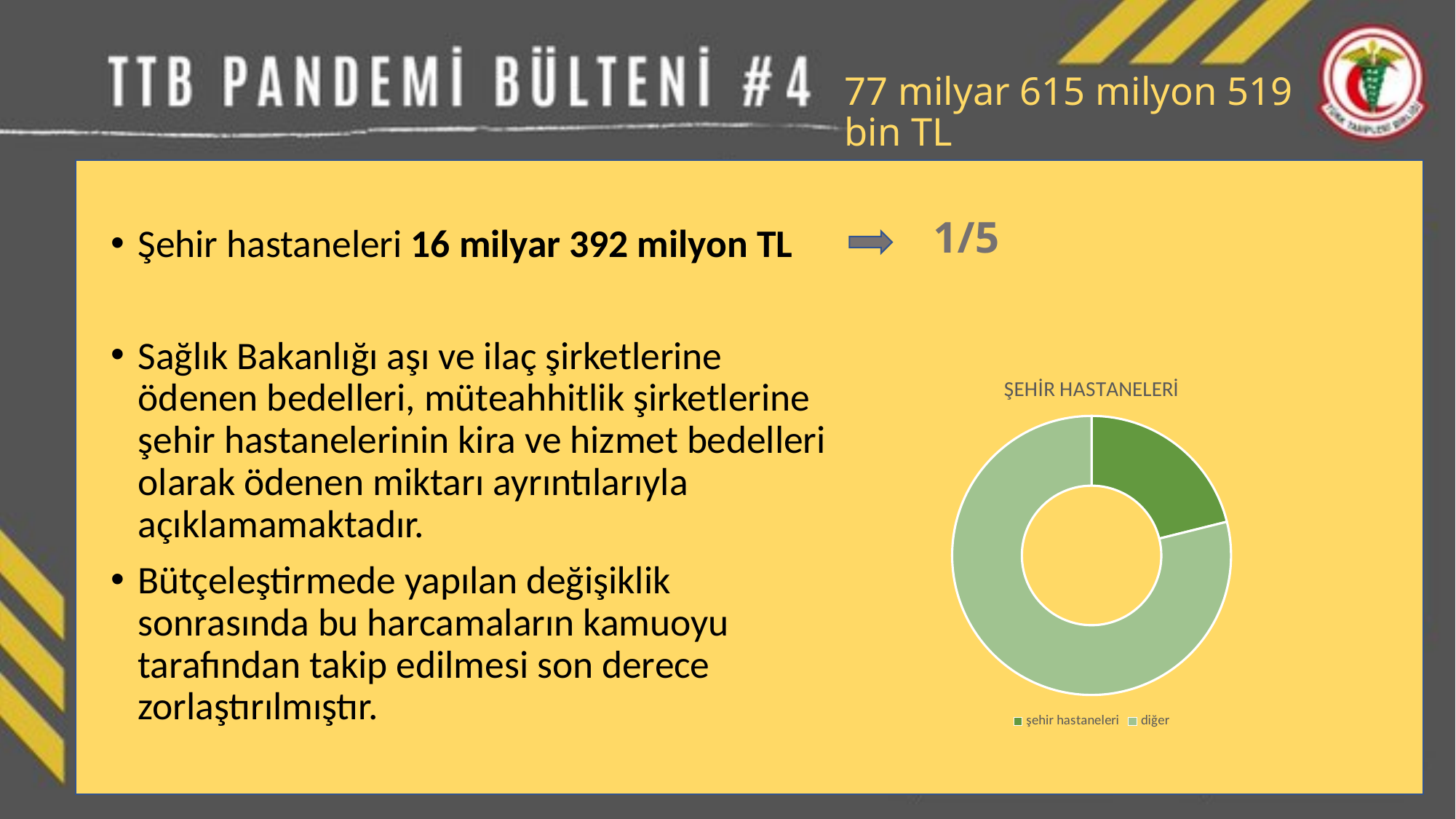
Which slice is larger, şehir hastaneleri or diğer? diğer Which slice of the chart is the smallest? şehir hastaneleri What is the title of the chart? ŞEHİR HASTANELERİ How many slices does the chart have? 2 What colour is the şehir hastaneleri slice in the chart? dark green What kind of chart is shown on the slide? doughnut chart How many entries does the chart legend list? 2 What are the two legend entries of the chart? şehir hastaneleri, diğer Which slice of the chart is the largest? diğer